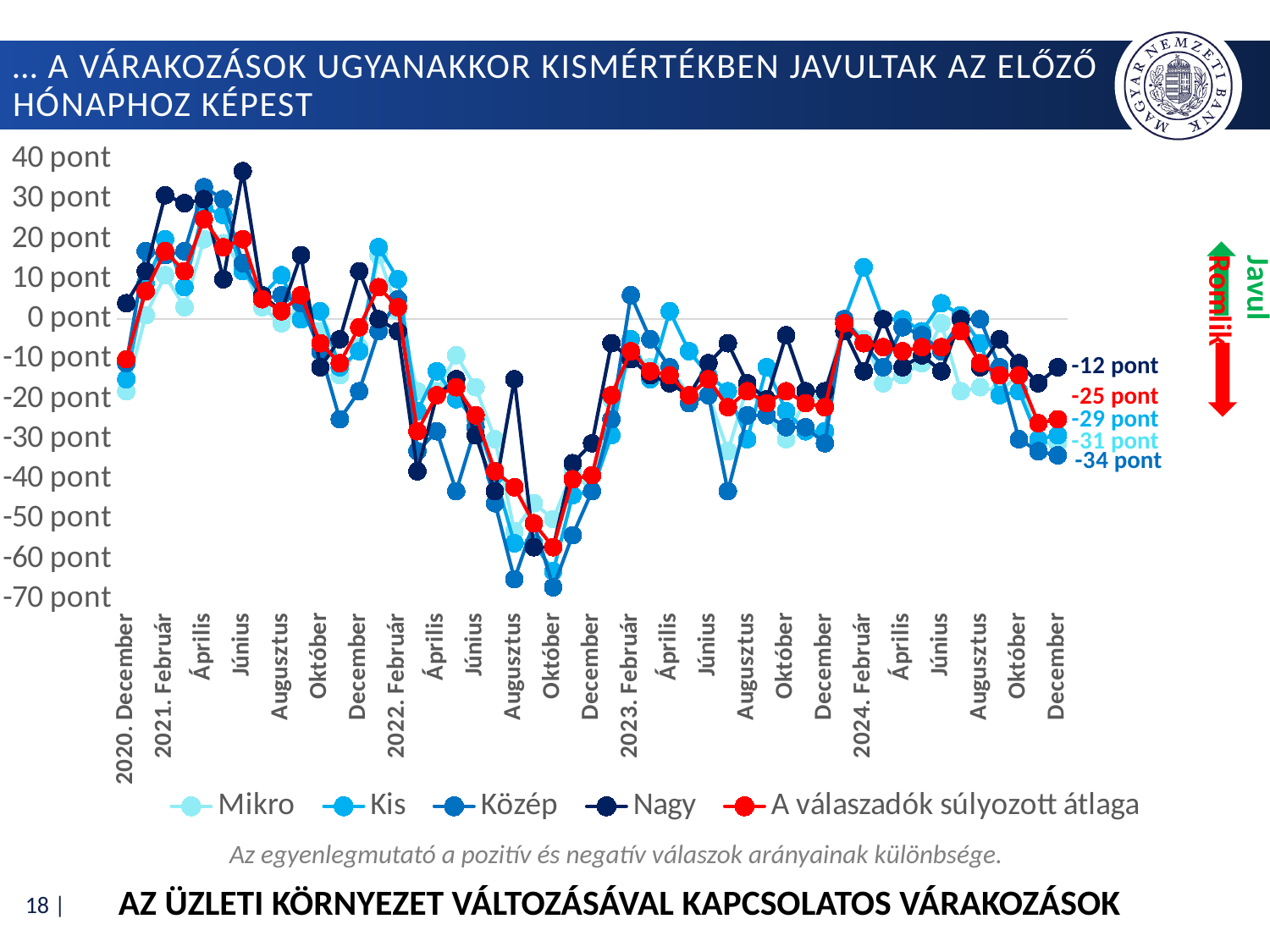
What is the value for the Nagy series at the end of the chart (2024 December)? -12 pont What is the value for 'A válaszadók súlyozott átlaga' at the end of the chart (2024 December)? -25 pont Does the weighted average ('A válaszadók súlyozott átlaga') rise or fall between 2022 Október and 2023 Február? rise At the end of the chart, which is larger: the Kis value or the Mikro value? Kis What kind of chart is shown on the slide? line chart Is the value of 'A válaszadók súlyozott átlaga' in 2022 Október greater or less than -50 pont? less Which series has the highest value at the end of the chart (2024 December)? Nagy What is the difference between the Nagy value (-12 pont) and the weighted average value (-25 pont) at the end of the chart? 13 pont How many series does the legend list? 5 Which series is drawn in red on the chart? A válaszadók súlyozott átlaga What is the value for the Közép series at the end of the chart (2024 December)? -34 pont Which series has the lowest value at the end of the chart (2024 December)? Közép